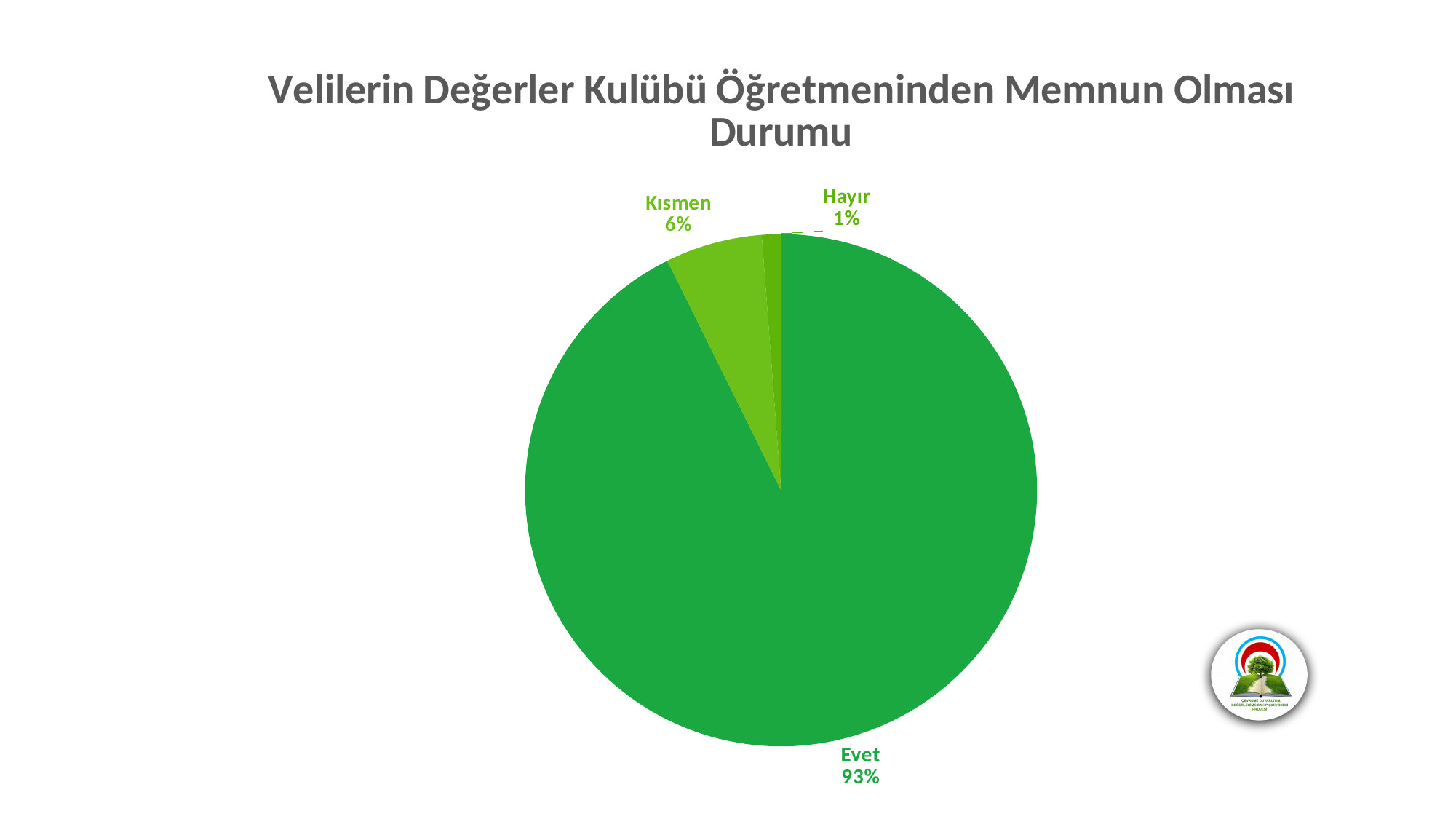
What kind of chart is shown on the slide? pie chart What is the difference in percentage points between Evet and Kısmen? 87 Which category has the largest slice? Evet What is the title of the chart? Velilerin Değerler Kulübü Öğretmeninden Memnun Olması Durumu What share of the pie does Evet represent? 93% What share of the pie does Hayır represent? 1% Which category has the smallest slice? Hayır What share of the pie does Kısmen represent? 6% Which is larger, the Kısmen slice or the Hayır slice? Kısmen What is the combined share of Kısmen and Hayır? 7% How many slices does the pie chart have? 3 What is the difference in percentage points between Kısmen and Hayır? 5